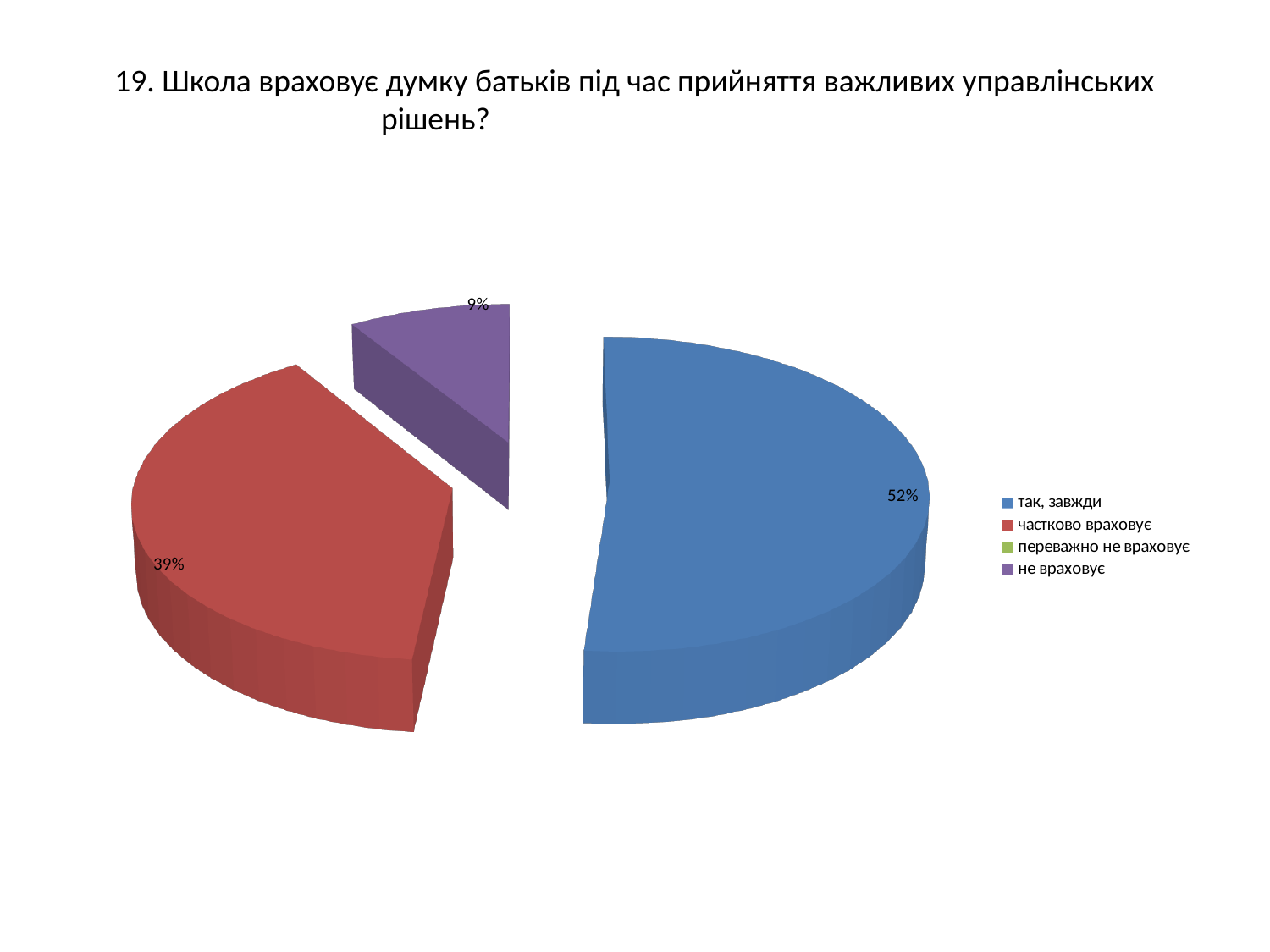
Which category has the largest slice of the pie? так, завжди What type of chart is shown on the slide? pie chart What is the difference in percentage points between "частково враховує" and "не враховує"? 30 What is the difference in percentage points between "так, завжди" and "частково враховує"? 13 How many entries does the legend list? 4 What share of the pie does "частково враховує" have? 39% What share of the pie does "так, завжди" have? 52% Which of the labelled slices is the smallest? не враховує What colour is the slice for "так, завжди"? blue Which is larger: the slice for "частково враховує" or the slice for "не враховує"? частково враховує Which legend entry has no visible slice in the pie? переважно не враховує What share of the pie does "не враховує" have? 9%